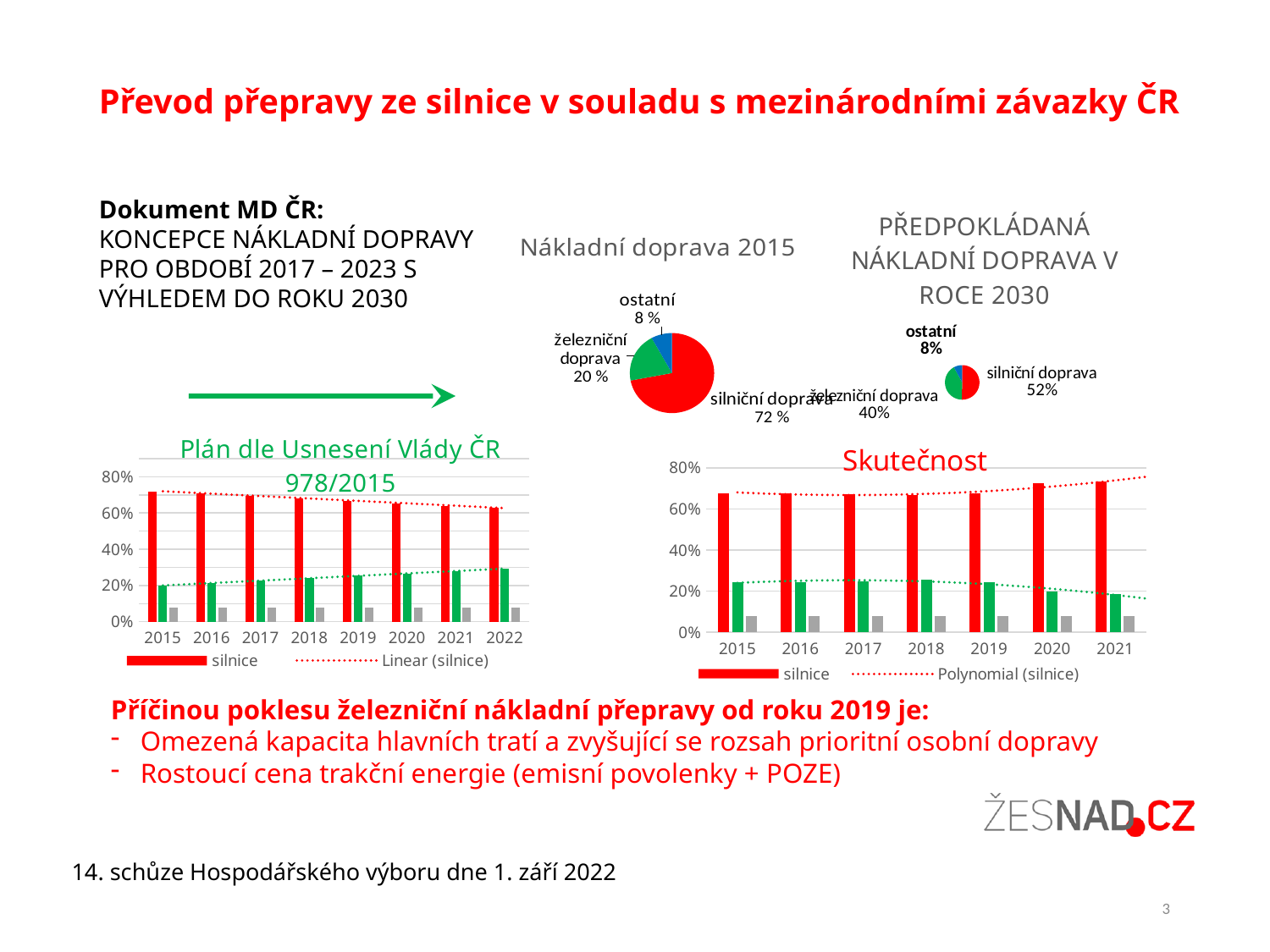
In the bar chart 'Plán dle Usnesení Vlády ČR 978/2015', is the red silnice bar for 2015 greater or less than 60%? greater In the pie chart 'PŘEDPOKLÁDANÁ NÁKLADNÍ DOPRAVA V ROCE 2030', what is the share for železniční doprava? 40% In the pie chart 'Nákladní doprava 2015', which category has the smallest share? ostatní In the pie chart 'Nákladní doprava 2015', what is the share for silniční doprava? 72 % How many years are shown on the x axis of the bar chart 'Skutečnost'? 7 In the pie chart 'PŘEDPOKLÁDANÁ NÁKLADNÍ DOPRAVA V ROCE 2030', what is the share for silniční doprava? 52% In the bar chart 'Skutečnost', do the red silnice bars rise or fall from 2015 to 2021? rise In the pie chart 'Nákladní doprava 2015', which category has the largest share? silniční doprava In the pie chart 'Nákladní doprava 2015', what is the difference between the shares of silniční doprava and železniční doprava? 52 % In the pie chart 'Nákladní doprava 2015', what is the share for železniční doprava? 20 % How many years are shown on the x axis of the bar chart 'Plán dle Usnesení Vlády ČR 978/2015'? 8 What kind of chart is 'Skutečnost'? bar chart